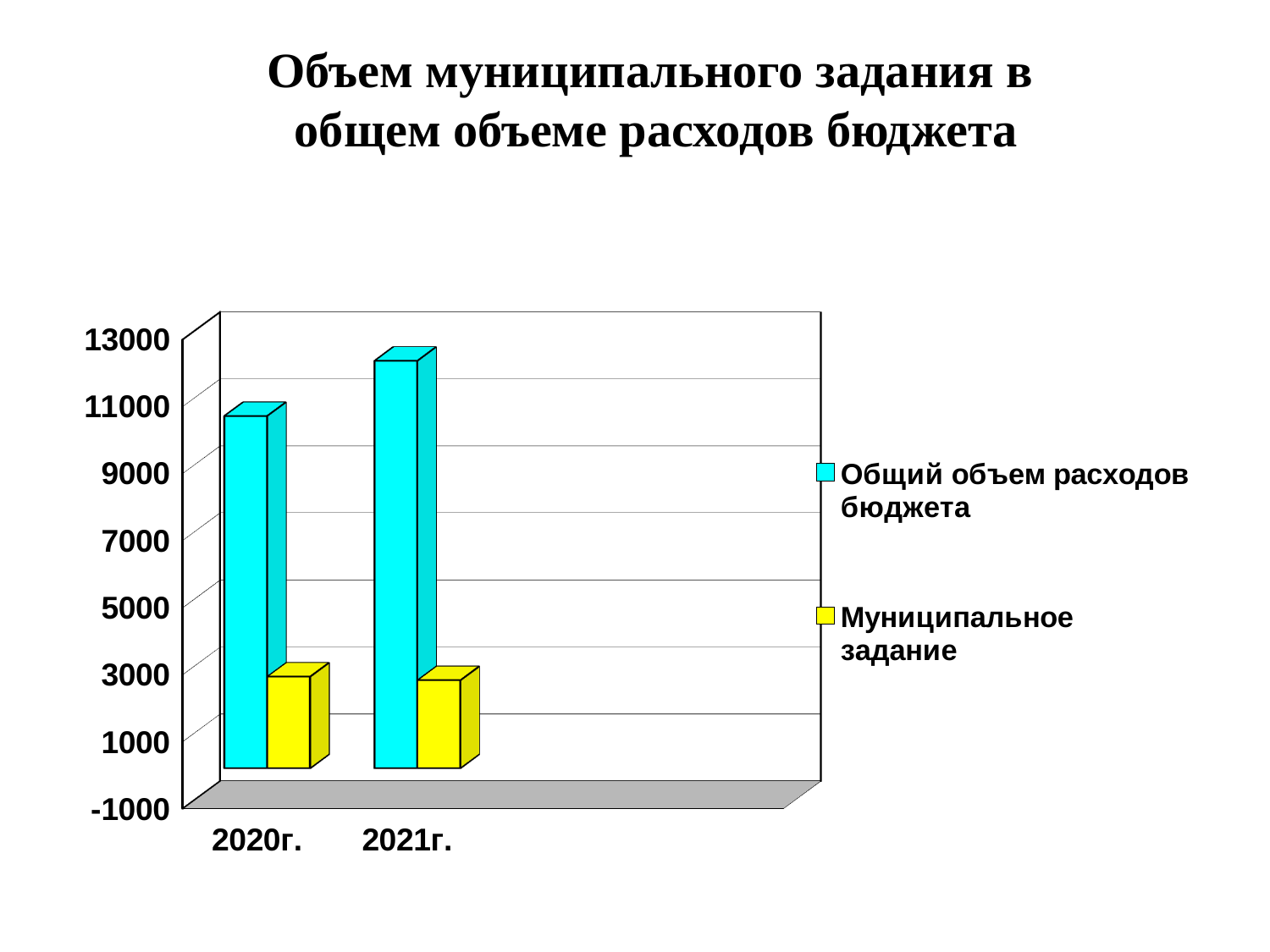
Which category has the highest value for Общий объем расходов бюджета? 2021г. Is the value for Муниципальное задание in 2021г. greater or less than 5000? less Does the value for Общий объем расходов бюджета rise or fall from 2020г. to 2021г.? rise What kind of chart is shown on the slide? bar chart What is the title of the chart on the slide? Объем муниципального задания в общем объеме расходов бюджета Is the value for Муниципальное задание in 2020г. greater or less than 5000? less How many series does the legend list? 2 Is the value for Общий объем расходов бюджета in 2020г. greater or less than 9000? greater How many categories are shown on the x axis of the chart? 2 In 2021г., which is larger: Общий объем расходов бюджета or Муниципальное задание? Общий объем расходов бюджета Which year has the higher value for Общий объем расходов бюджета, 2020г. or 2021г.? 2021г.